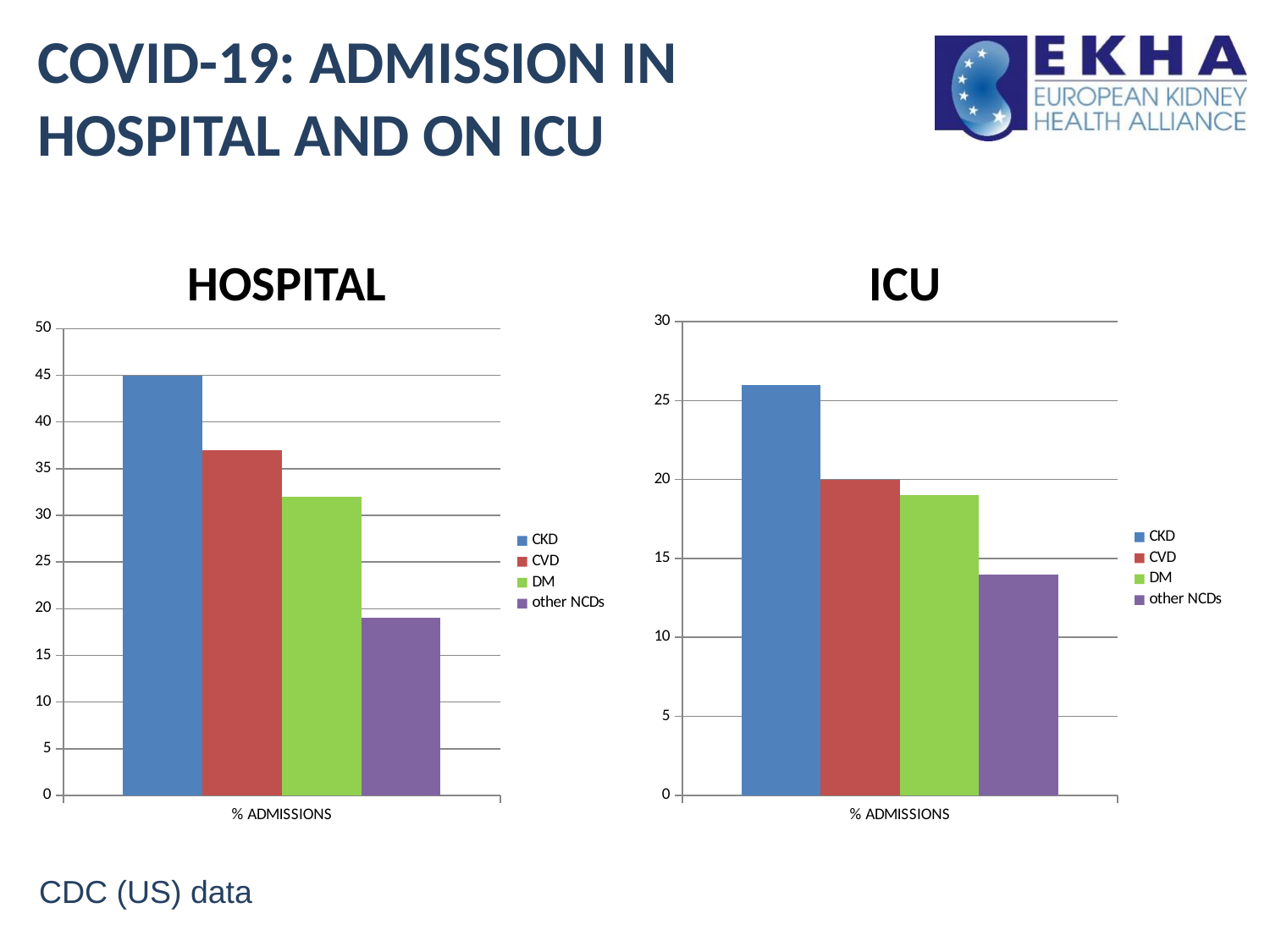
On the HOSPITAL chart, is the value for other NCDs greater or less than 20? less On the HOSPITAL chart, is the value for CVD greater or less than 35? greater On the ICU chart, what is the value for CVD? 20 On the ICU chart, is the value for CKD greater or less than 25? greater What kind of chart is the HOSPITAL chart? bar chart On the HOSPITAL chart, which series has the highest value? CKD What is the x-axis label on the ICU chart? % ADMISSIONS How many series does the legend of the ICU chart list? 4 On the HOSPITAL chart, what is the value for CKD? 45 On the ICU chart, which series has the lowest value? other NCDs On the HOSPITAL chart, which is larger, the value for CVD or the value for DM? CVD